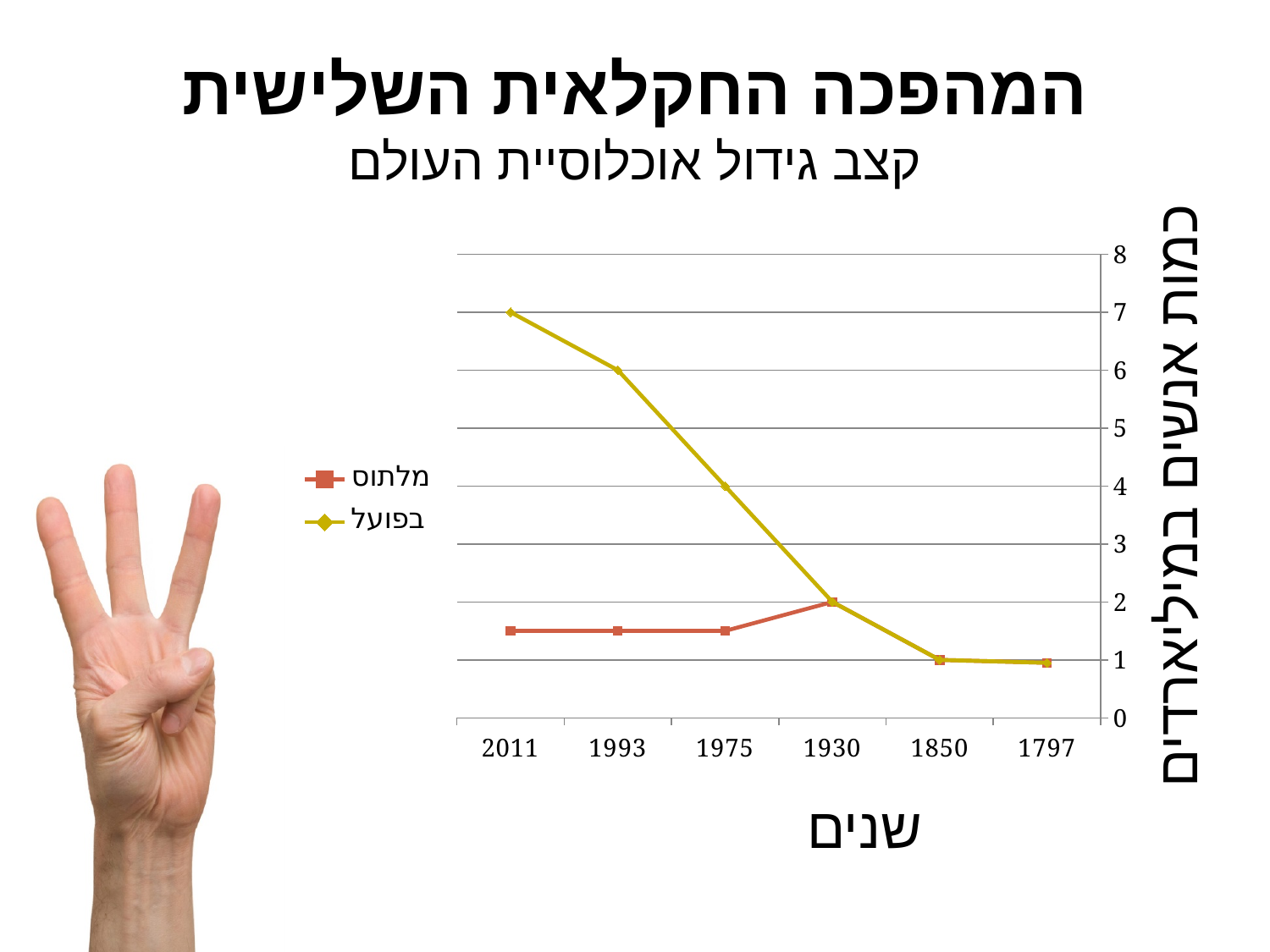
Is the value of the מלתוס series for 2011 greater or less than 2? less What is the difference between the בפועל values for 2011 and 1993? 1 What is the value of the בפועל series for 1930? 2 What is the value of the בפועל series for 1993? 6 What is the title of the y axis? כמות אנשים במיליארדים How many years are labelled on the x axis? 6 For which year is the בפועל series highest? 2011 For 1975, which series has the larger value, מלתוס or בפועל? בפועל What kind of chart is shown on the slide? line chart How many series does the legend list? 2 What is the value of the בפועל series for 2011? 7 What is the value of the בפועל series for 1975? 4